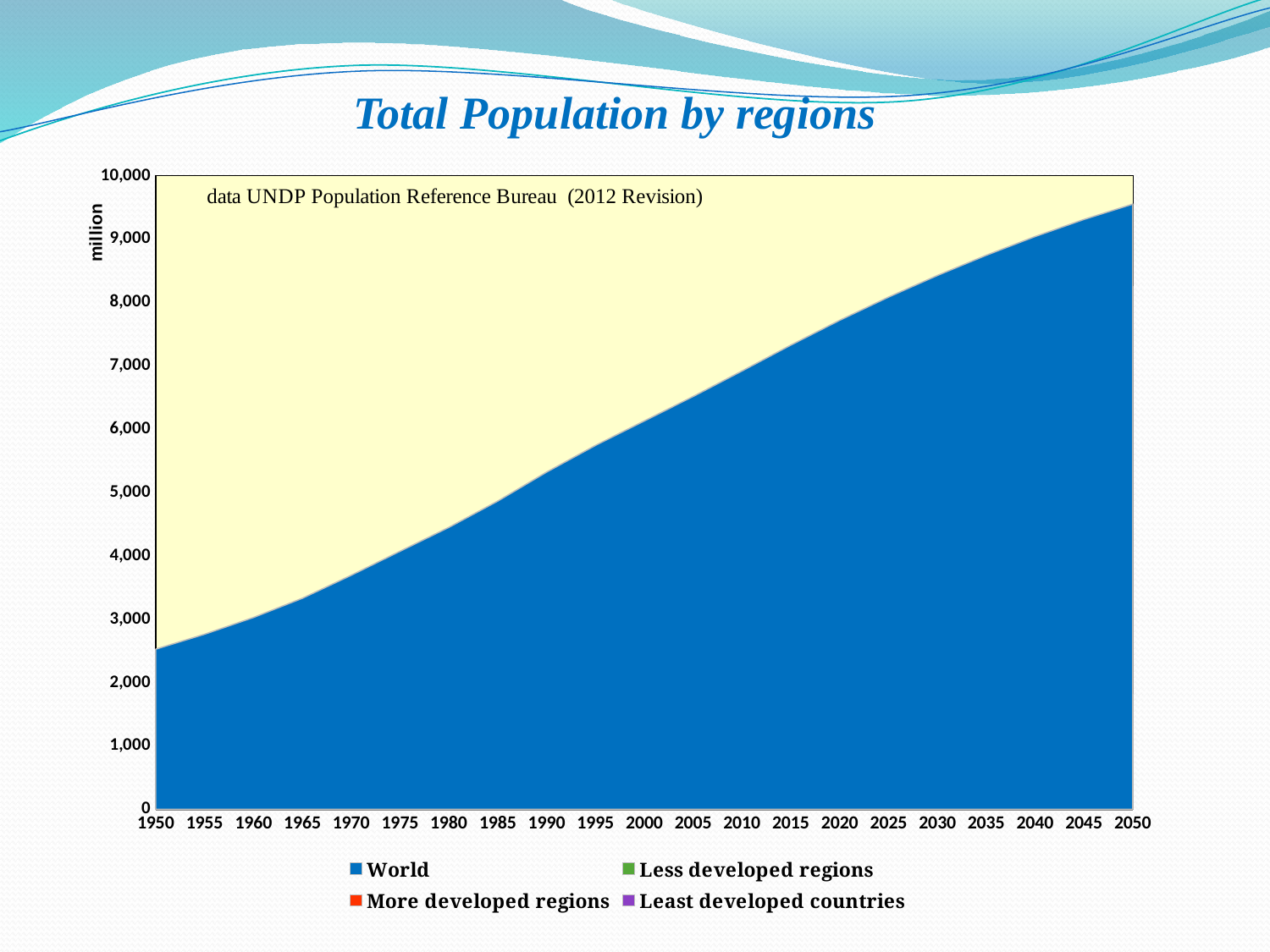
What kind of chart is shown on the slide? Area chart What unit is shown on the y axis? million Is the World value for 1950 greater or less than 2,000? greater Is the World value for 1980 greater or less than 4,000? greater Which year has the highest World population on the chart? 2050 Which year has the lowest World population on the chart? 1950 How many series does the legend list? 4 Is the World value for 2020 greater or less than 8,000? less Does the World population rise or fall from 1950 to 2050? Rises How many years are labelled along the x axis? 21